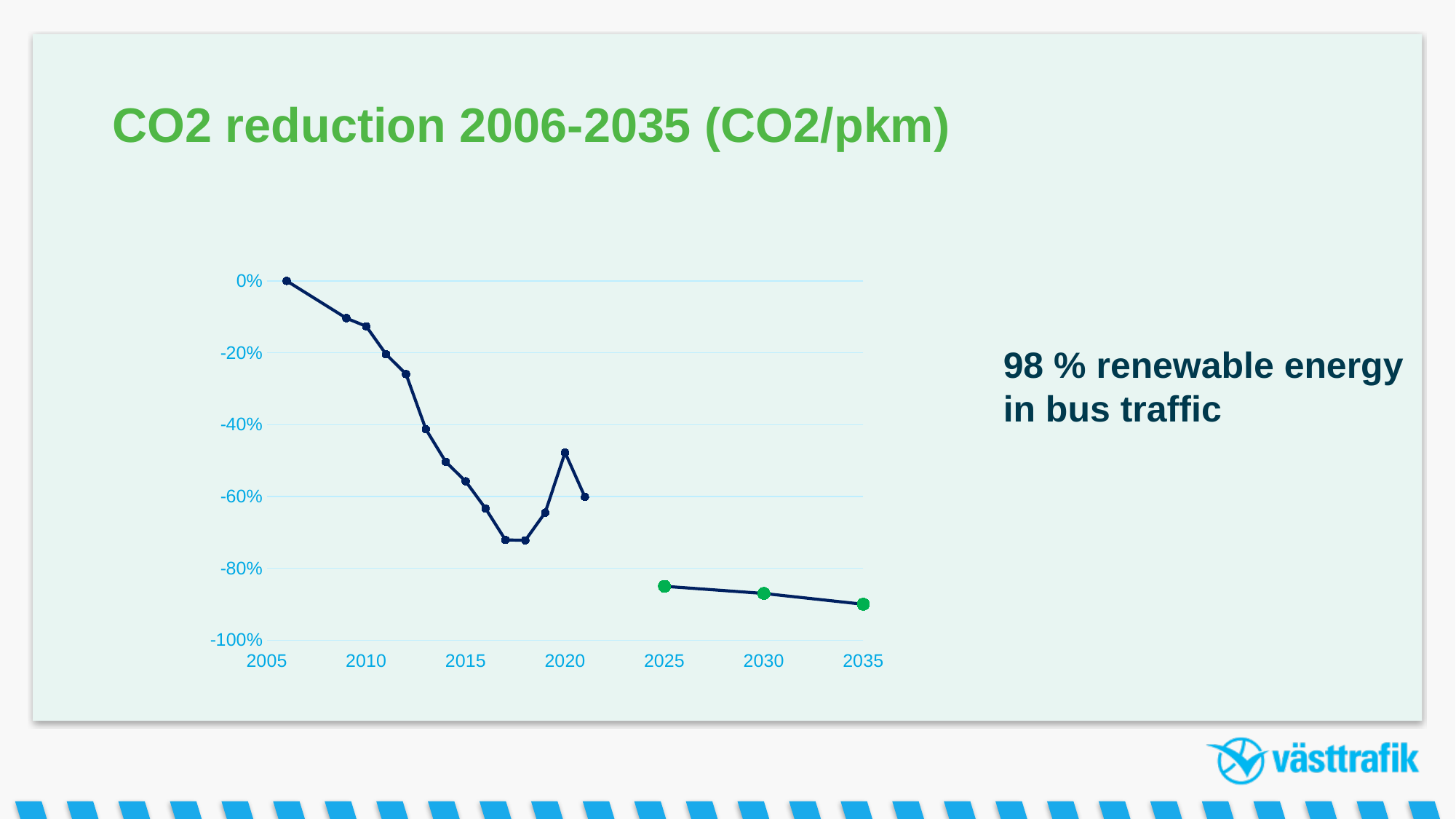
Is the value for 2013 greater or less than -20%? less Is the value for 2020 greater or less than -60%? greater Which year has the highest value on the chart? 2006 What is the title of the chart? CO2 reduction 2006-2035 (CO2/pkm) What kind of chart is shown on the slide? line chart Do the values generally rise or fall from 2006 to 2035? fall What is the value of the first plotted point, at 2006? 0% Which year has the lowest value on the chart? 2035 Which is larger, the value for 2020 or the value for 2018? 2020 How many points on the chart are marked in green? 3 Is the value for 2035 greater or less than -80%? less